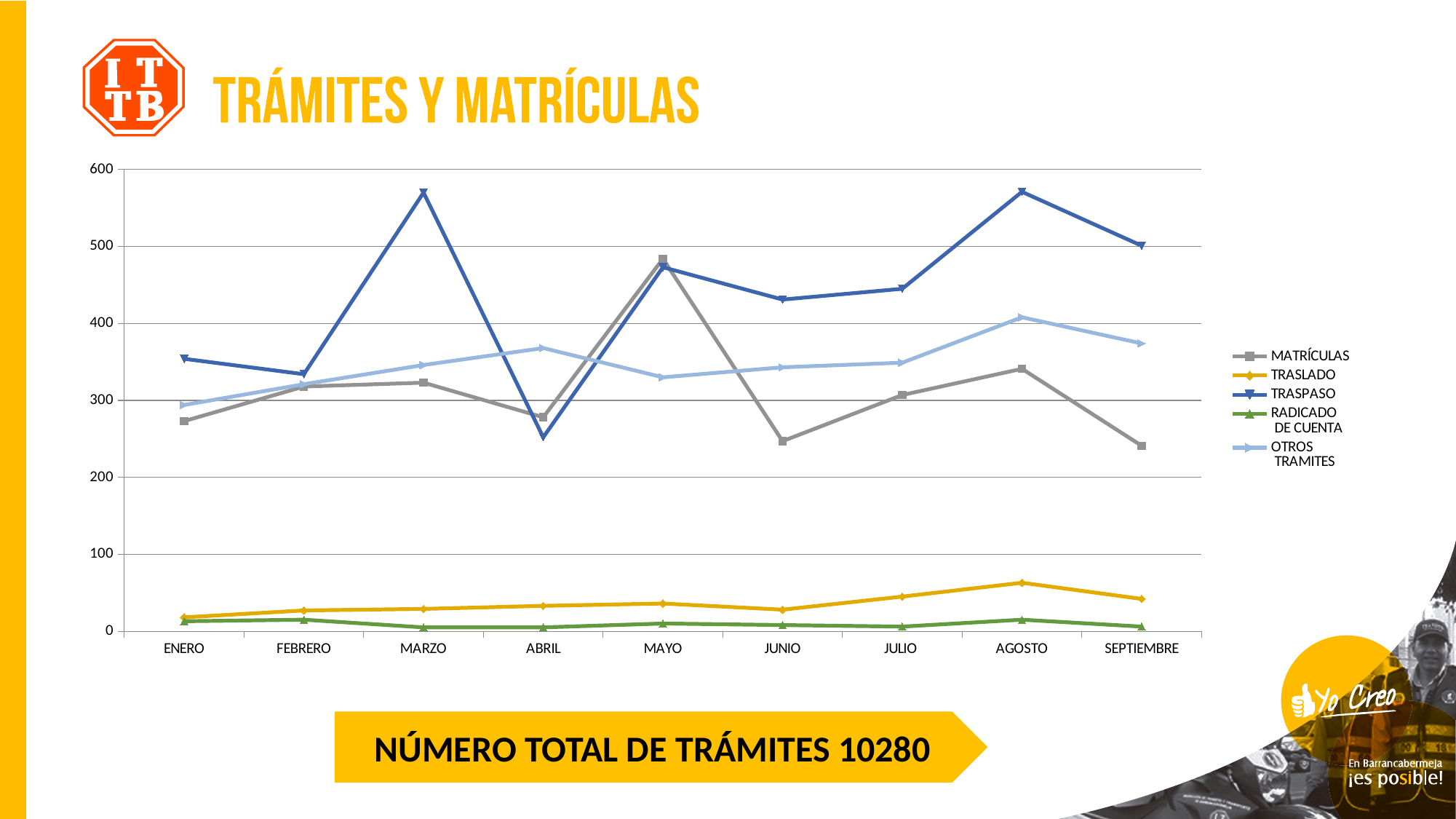
Does the TRASPASO line rise or fall from JUNIO to AGOSTO? rise How many series does the legend list? 5 What kind of chart is shown on the slide? line chart In ABRIL, which series has the larger value, OTROS TRAMITES or TRASPASO? OTROS TRAMITES In which month is the MATRÍCULAS value highest? MAYO Is the MATRÍCULAS value for JUNIO greater or less than 300? less Is the TRASLADO value for AGOSTO greater or less than 100? less How many months are shown on the x axis? 9 What is the title of the slide containing the chart? TRÁMITES Y MATRÍCULAS In which month is the OTROS TRAMITES value highest? AGOSTO In which month is the TRASPASO value lowest? ABRIL Is the TRASPASO value for MARZO greater or less than 500? greater